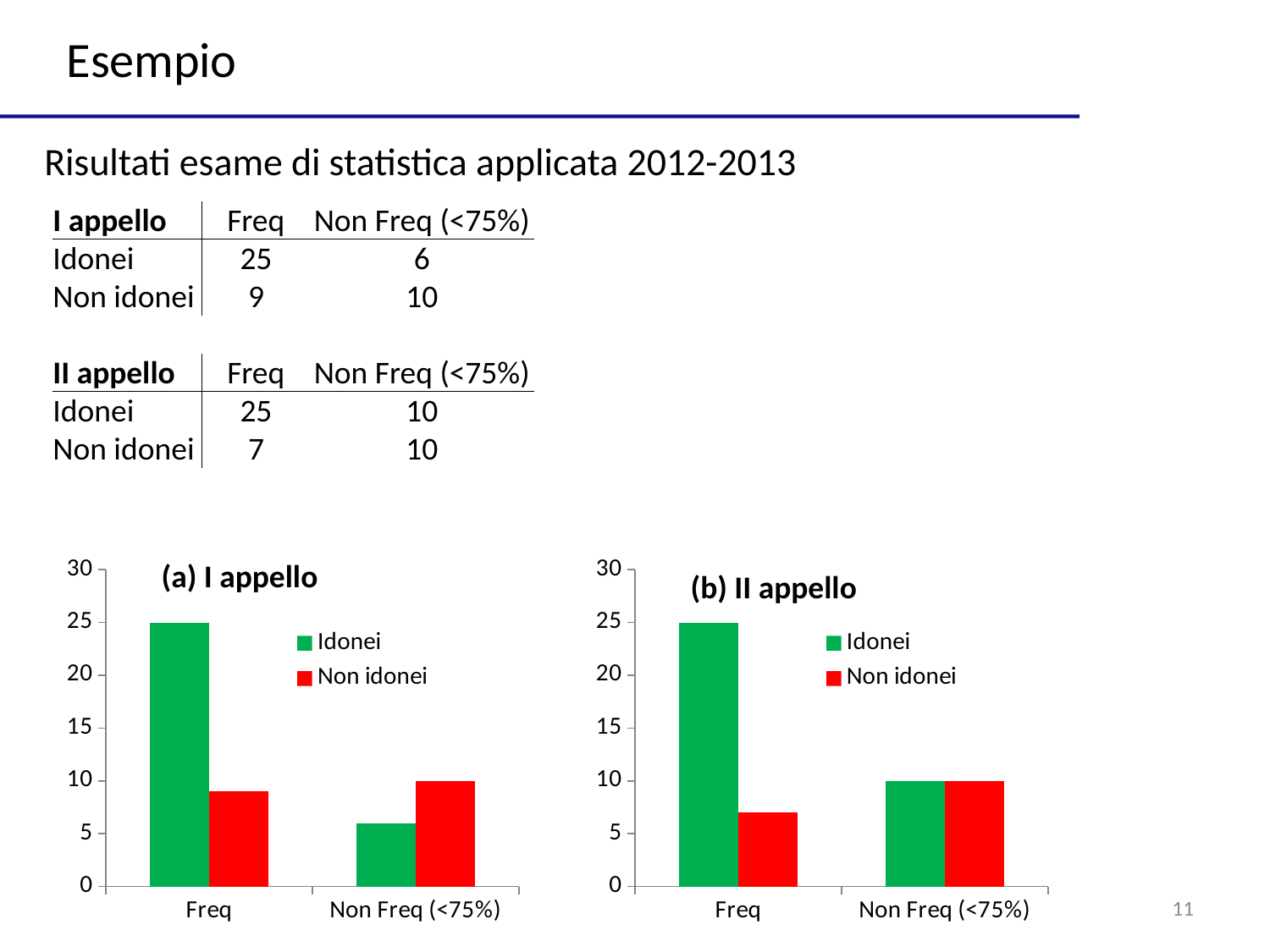
In chart (a) I appello, what is the value for Idonei in the Freq category? 25 What kind of chart is chart (b) II appello? bar chart In chart (b) II appello, what is the difference between the Idonei value for Freq and the Idonei value for Non Freq (<75%)? 15 In chart (b) II appello, what is the value for Non idonei in the Non Freq (<75%) category? 10 In chart (a) I appello, in the Non Freq (<75%) category, which is larger: Idonei or Non idonei? Non idonei In chart (a) I appello, which series has the highest bar overall? Idonei How many categories are shown on the x axis of chart (b) II appello? 2 In chart (a) I appello, is the value for Non idonei in the Freq category greater or less than 10? less How many series does the legend of chart (a) I appello list? 2 In chart (a) I appello, what colour represents the Idonei series? green In chart (b) II appello, what is the value for Idonei in the Freq category? 25 In chart (b) II appello, is the value for Non idonei in the Freq category greater or less than 5? greater